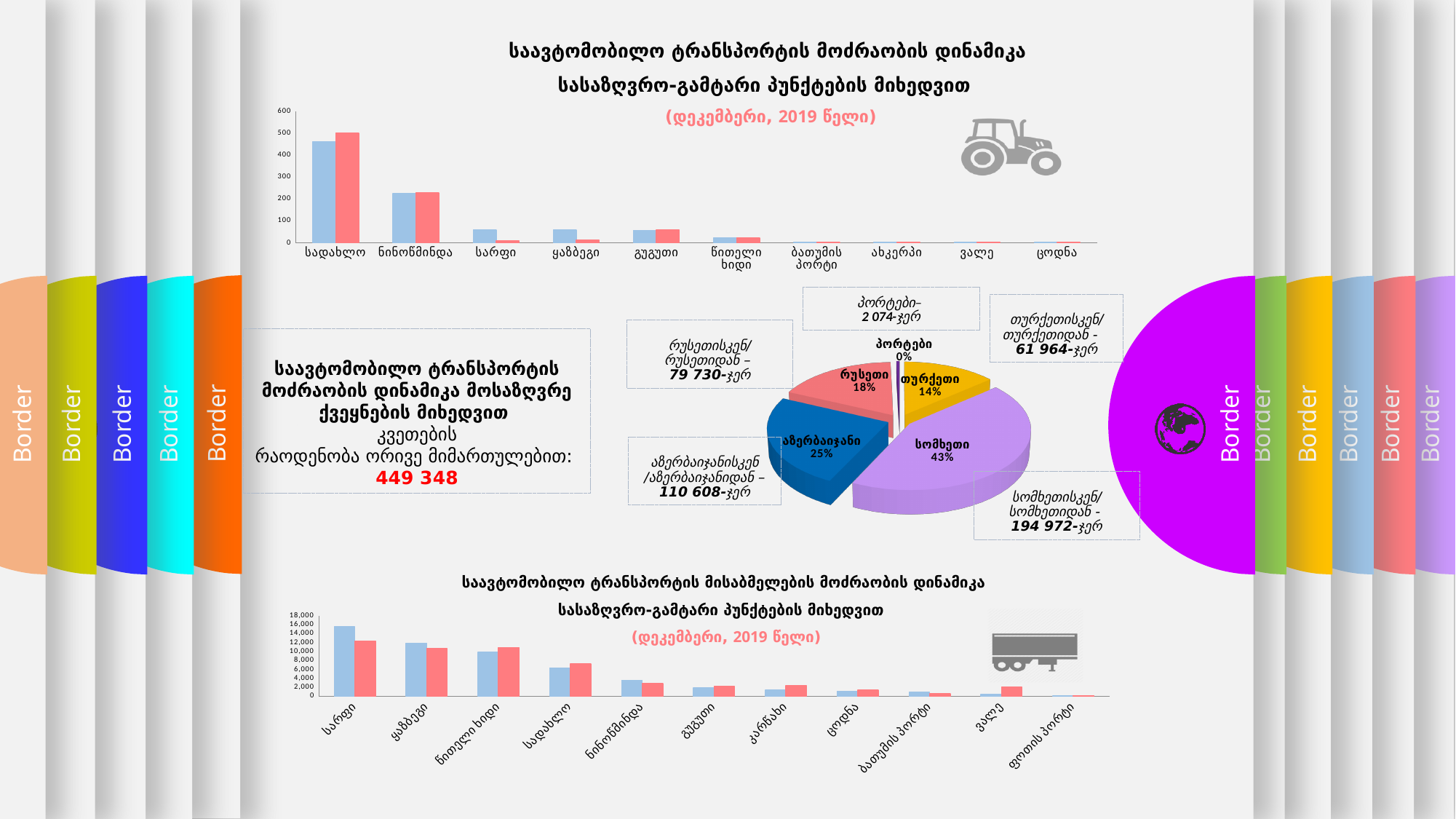
In the top bar chart, is the blue bar for სადახლო greater or less than 400? greater In the pie chart, which slice is the smallest? პორტები In the bottom bar chart, is the blue bar for სარფი greater or less than 14,000? greater How many categories are shown on the x axis of the bottom bar chart? 11 In the top bar chart, are the bars for ნინოწმინდა greater or less than 300? less In the pie chart, which slice is the largest? სომხეთი How many categories are shown on the x axis of the top bar chart? 10 In the pie chart, what share does სომხეთი have? 43% What kind of chart is the top chart on the slide? bar chart How many slices does the pie chart have? 5 What kind of chart is the middle chart on the slide? pie chart In the top bar chart, which category has the highest values? სადახლო